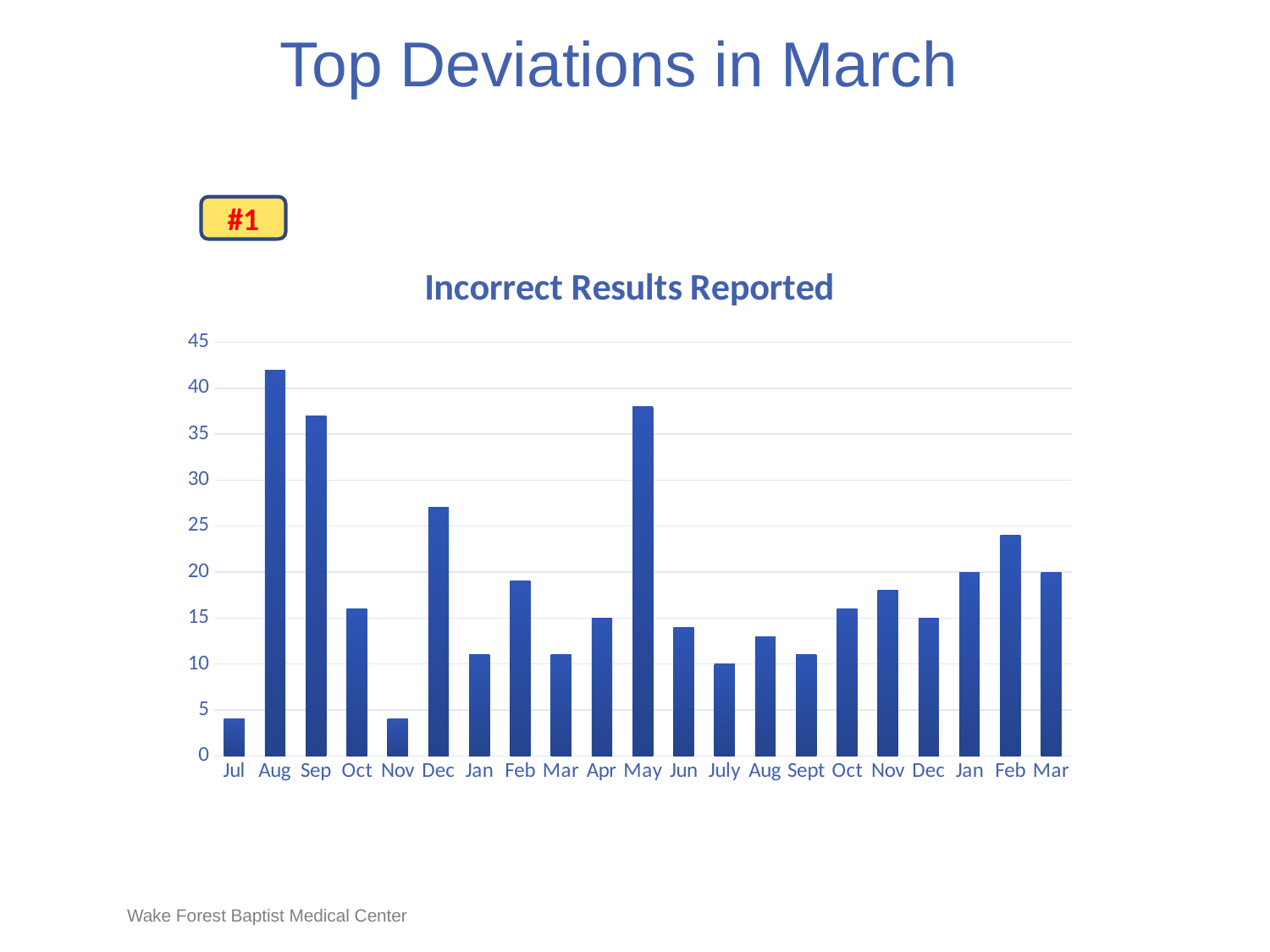
Is the value for the first Jul bar greater or less than 5? less Is the value for the first Dec bar greater or less than 25? greater What is the title of the chart? Incorrect Results Reported Which month has the highest bar in the chart? Aug (the first Aug bar) What is the value for July? 10 Which is larger, the first Dec bar or the second Feb bar? Dec How many bars are plotted in the chart? 21 Is the value for the first Aug bar greater or less than 40? greater What kind of chart is shown on the slide? bar chart Which is larger, the first Aug bar or the Sep bar? Aug